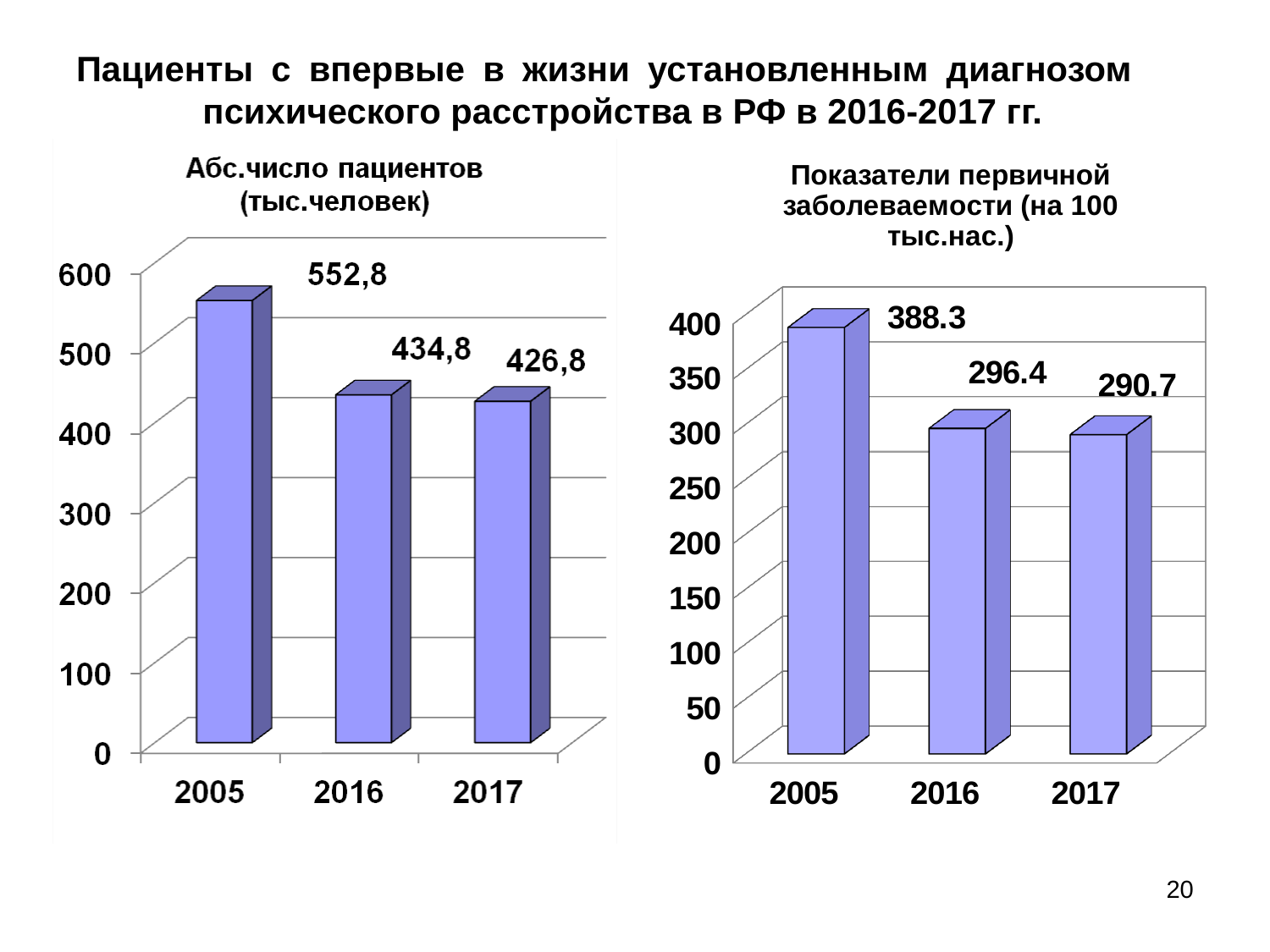
In the left chart (Абс.число пациентов), what is the value for 2017? 426,8 In the right chart (Показатели первичной заболеваемости), what is the value for 2017? 290.7 How many bars are shown in the left chart (Абс.число пациентов)? 3 What type of chart is the right chart (Показатели первичной заболеваемости)? Bar chart In the left chart (Абс.число пациентов), do the values rise or fall from 2005 to 2017? Fall In the right chart (Показатели первичной заболеваемости), what is the value for 2016? 296.4 In the left chart (Абс.число пациентов), which year has the highest value? 2005 In the left chart (Абс.число пациентов), what is the value for 2005? 552,8 In the right chart (Показатели первичной заболеваемости), what is the difference between the values for 2005 and 2016? 91.9 In the right chart (Показатели первичной заболеваемости), which year has the lowest value? 2017 In the left chart (Абс.число пациентов), what is the difference between the values for 2005 and 2016? 118,0 In the right chart (Показатели первичной заболеваемости), which is larger, the value for 2005 or the value for 2017? 2005